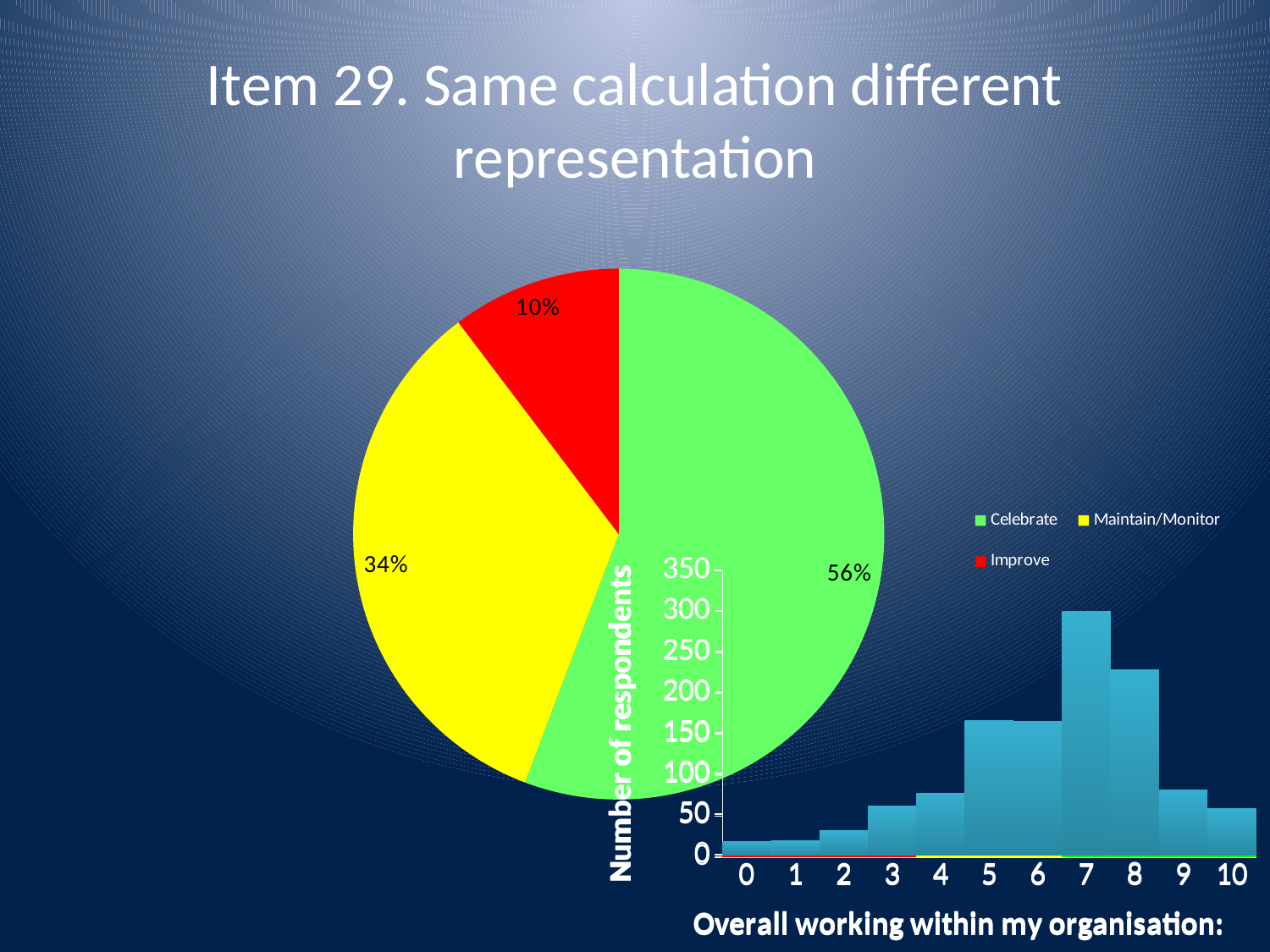
On the bar chart at the bottom right, which category has the tallest bar? 7 On the pie chart, what share does Maintain/Monitor have? 34% On the bar chart at the bottom right, is the value for 8 greater or less than 200? greater On the pie chart, which category has the smallest share? Improve On the bar chart at the bottom right, how many categories are shown on the x axis? 11 On the pie chart, what share does Celebrate have? 56% On the pie chart, what share does Improve have? 10% On the pie chart, which category has the largest share? Celebrate On the pie chart, what is the difference in percentage points between Celebrate and Maintain/Monitor? 22 On the pie chart, what colour is the Improve slice? Red On the pie chart, how many categories does the legend list? 3 What kind of chart is the chart at the bottom right with the x axis labelled 'Overall working within my organisation:'? Bar chart